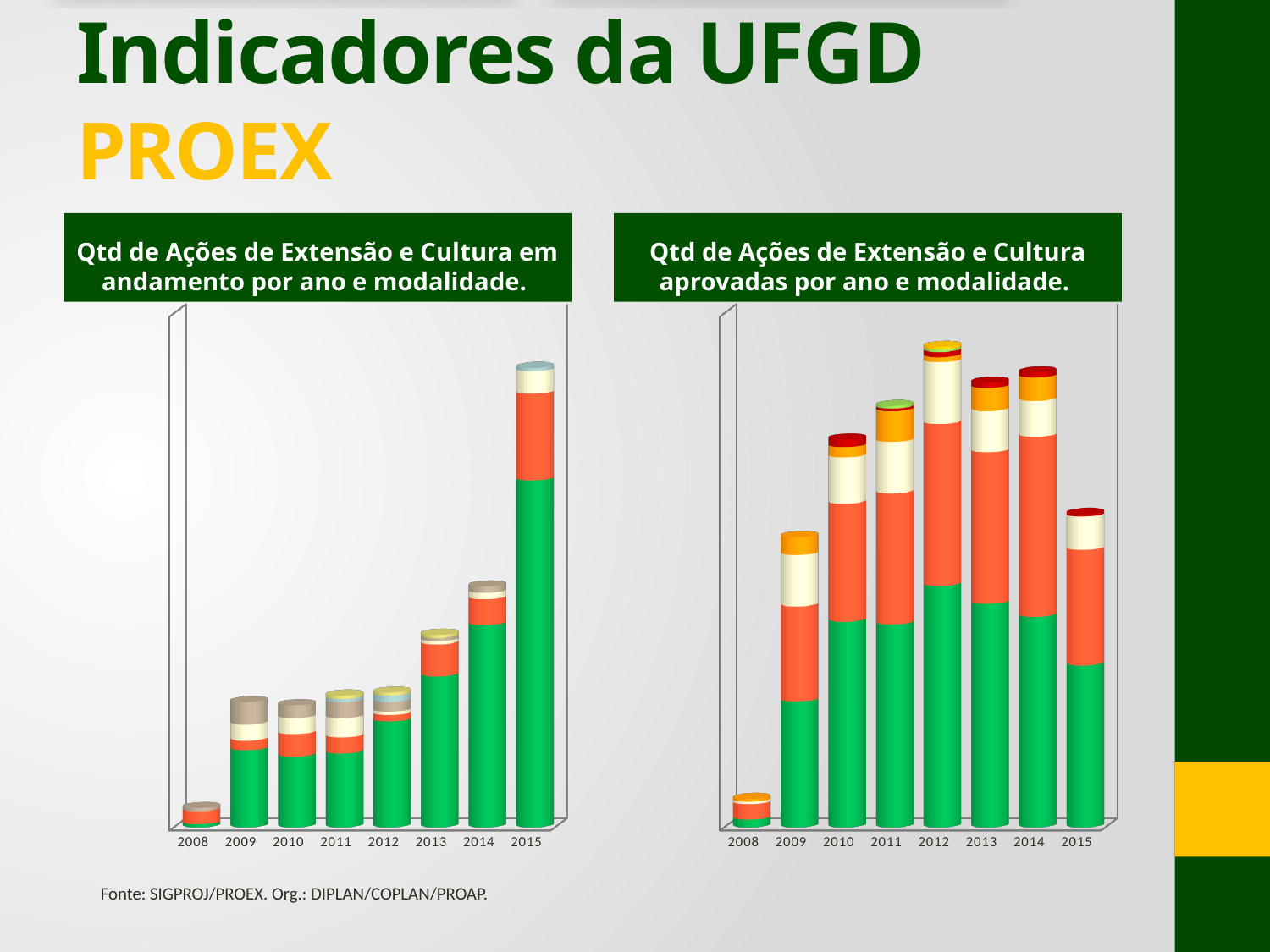
How many years are shown on the x axis of the right chart, 'Qtd de Ações de Extensão e Cultura aprovadas por ano e modalidade'? 8 In the left chart (ações em andamento), do the bar heights generally rise or fall from 2008 to 2015? Rise In the left chart (ações em andamento), which year has the shortest bar? 2008 What kind of chart is the left chart, 'Qtd de Ações de Extensão e Cultura em andamento por ano e modalidade'? Stacked bar chart In the right chart (ações aprovadas), which year has the shortest bar? 2008 In the right chart (ações aprovadas), is the bar for 2014 or 2015 taller? 2014 What is the title of the right chart? Qtd de Ações de Extensão e Cultura aprovadas por ano e modalidade. In the left chart (ações em andamento), which year has the tallest bar? 2015 In the left chart (ações em andamento), is the bar for 2013 or 2014 taller? 2014 In the right chart (ações aprovadas), which year has the tallest bar? 2012 In the right chart (ações aprovadas), is the bar for 2009 or 2010 taller? 2010 What is the first year shown on the x axis of the left chart? 2008